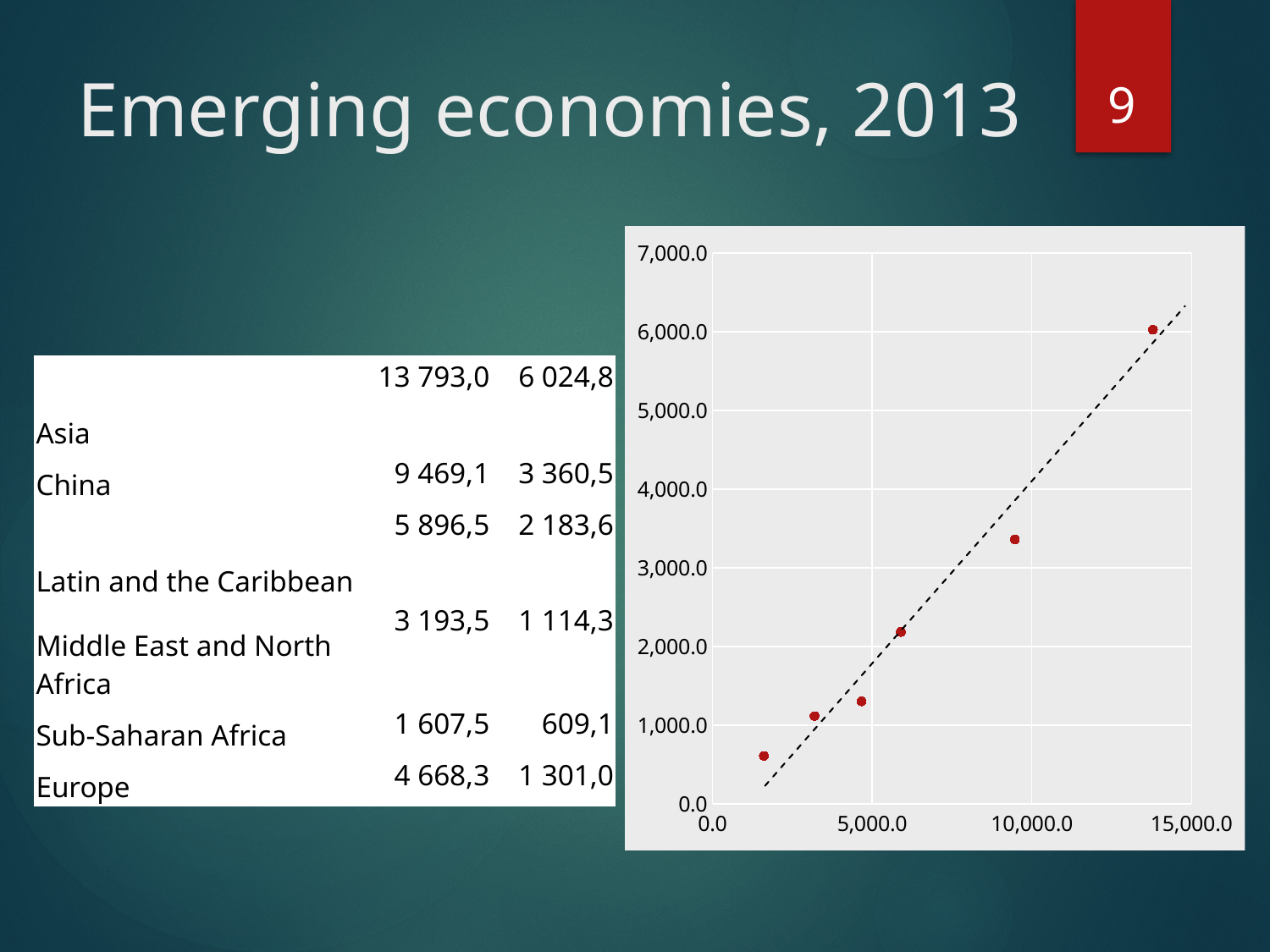
Is the y value of the rightmost plotted point greater or less than 4,000.0? greater Is the x value of the leftmost plotted point greater or less than 5,000.0? less Is the y value of the highest plotted point greater or less than 5,000.0? greater Do the plotted points rise or fall as the x-axis value increases? rise What is the highest tick value shown on the x axis? 15,000.0 What is the highest tick value shown on the y axis? 7,000.0 How many data points are plotted on the chart? 6 How many plotted points have a y value below 2,000.0? 3 How many plotted points have an x value greater than 10,000.0? 1 What kind of chart is shown on the slide? scatter chart